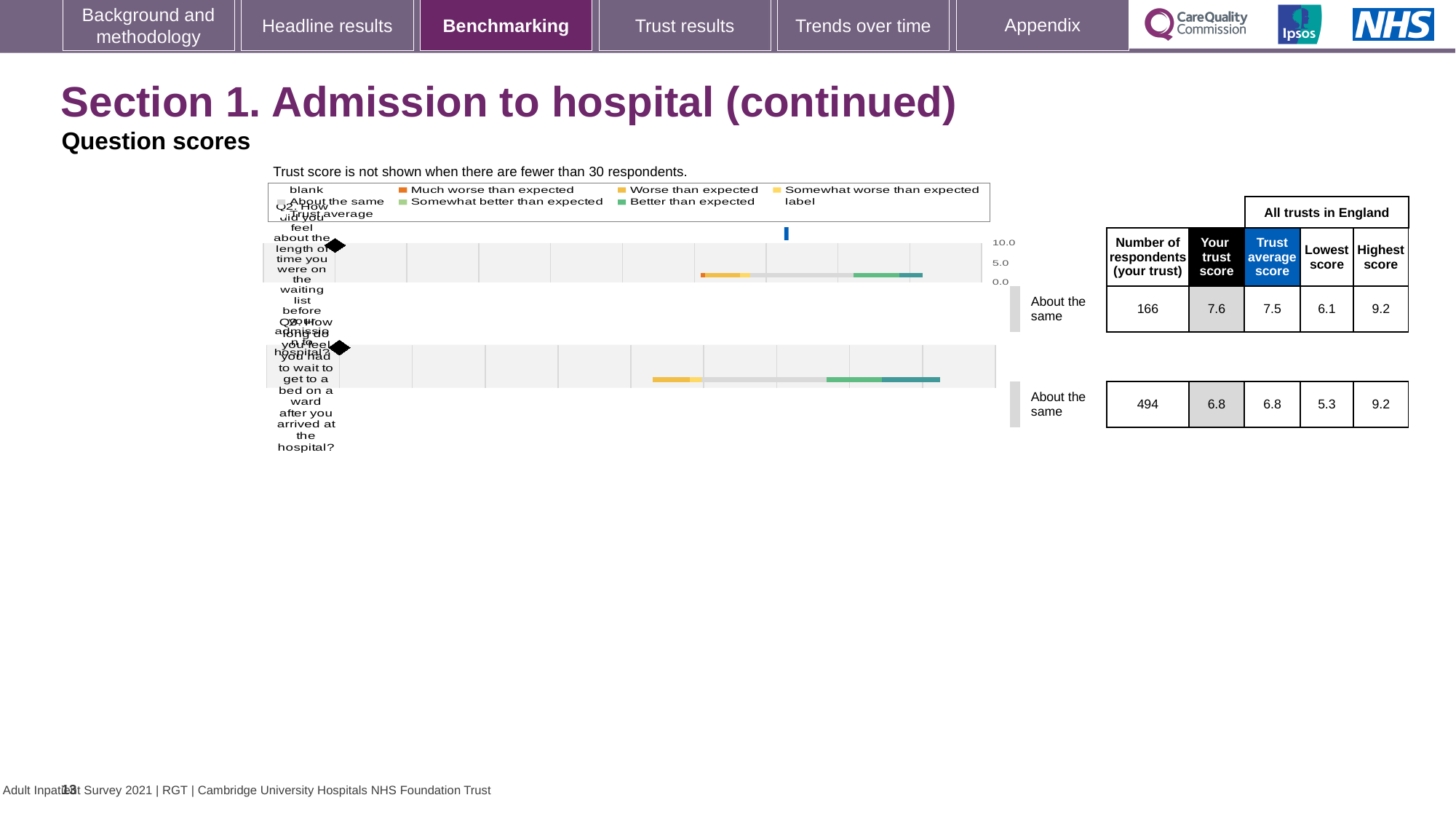
Which question has the higher trust score, Q2 or Q3? Q2 What kind of chart is used to show the question scores on this slide? bar chart What is the trust score for Q2 (how did you feel about the length of time on the waiting list before admission)? 7.6 What benchmark category is shown for Q3 on this slide? About the same How many questions (bars) are plotted in the benchmarking charts on this slide? 2 By how much does the trust score for Q2 exceed the trust average score for Q2? 0.1 How many respondents answered Q2 for this trust? 166 What is the trust score for Q3 (how long did you feel you had to wait to get to a bed on a ward)? 6.8 How many respondents answered Q3 for this trust? 494 What is the trust average score across all trusts in England for Q2? 7.5 What is the highest score among all trusts in England for Q2? 9.2 What is the lowest score among all trusts in England for Q3? 5.3